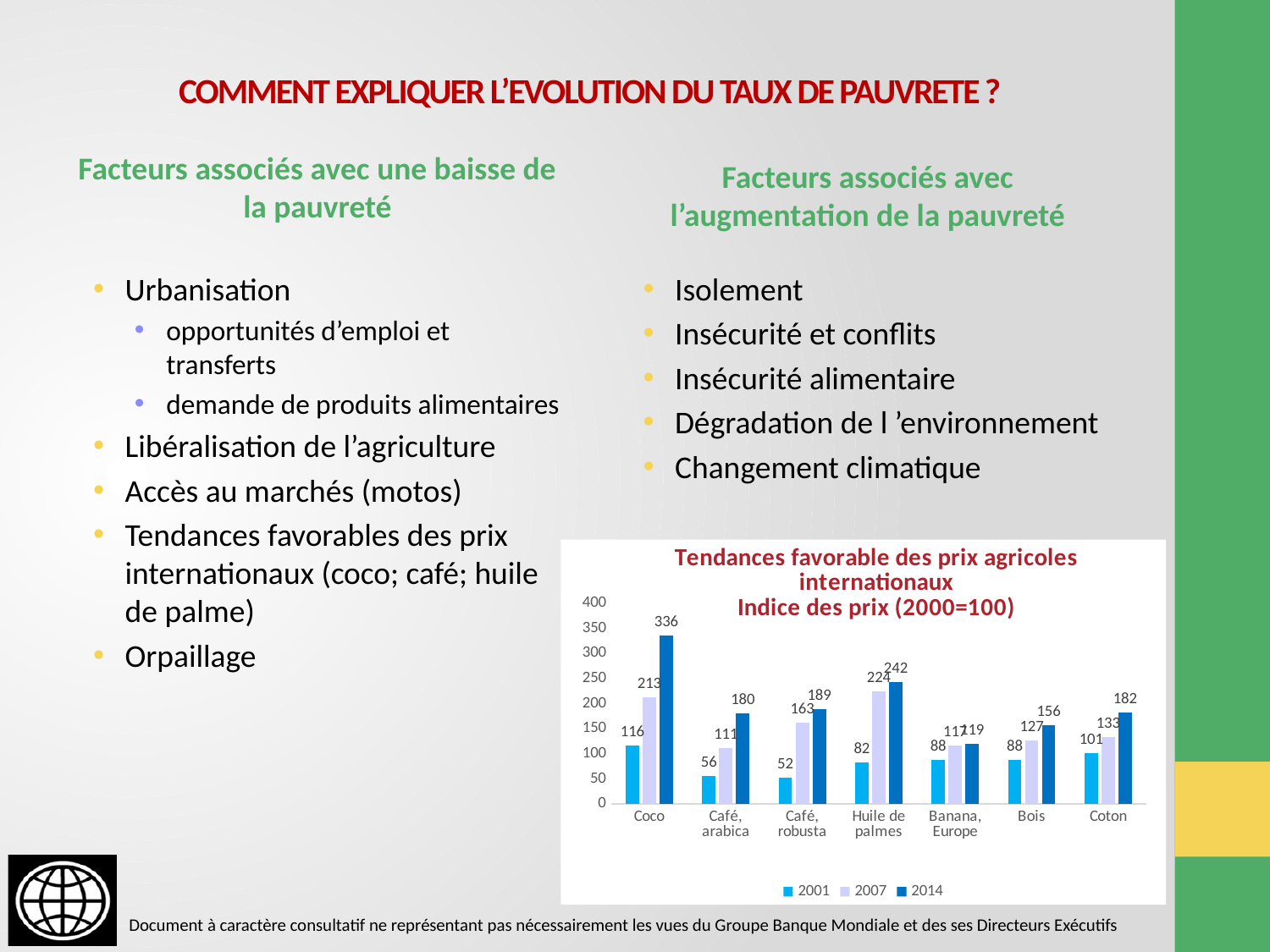
What is the 2014 value for Coco? 336 How many series does the legend list? 3 How many categories are shown on the x axis? 7 What kind of chart is shown on the slide? Bar chart What is the 2007 value for Huile de palmes? 224 Which category has the highest 2014 value? Coco Which category has the lowest 2001 value? Café, robusta Which is larger, the 2014 value for Bois or the 2014 value for Coton? Coton For Café, arabica, do the values rise or fall from 2001 to 2014? Rise What is the 2001 value for Café, robusta? 52 What is the difference between the 2014 and 2001 values for Coco? 220 What is the 2014 value for Coton? 182